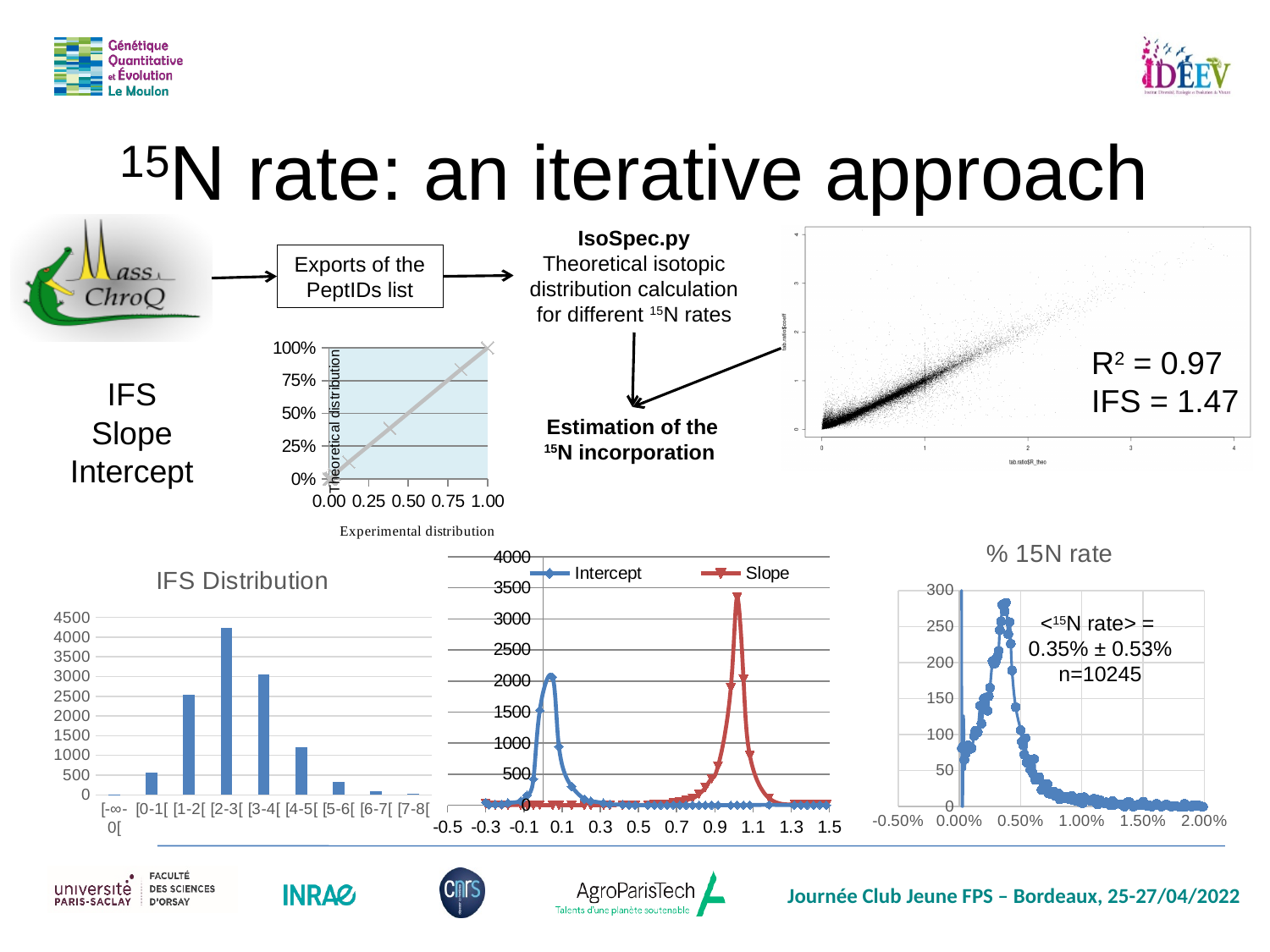
In the Intercept/Slope chart, is the peak value of the Slope series greater or less than 3000? greater What kind of chart is the IFS Distribution chart? bar chart In the IFS Distribution chart, is the value for [2-3[ greater or less than 4000? greater In the IFS Distribution chart, is the value for [5-6[ greater or less than 500? less What R² value is printed next to the scatter plot at the top right of the slide? 0.97 How many categories are shown on the x axis of the IFS Distribution chart? 9 In the IFS Distribution chart, which is larger, the value for [1-2[ or the value for [4-5[? [1-2[ In the Intercept/Slope chart, which series reaches the higher peak? Slope In the IFS Distribution chart, which category has the highest bar? [2-3[ How many series does the legend of the Intercept/Slope chart list? 2